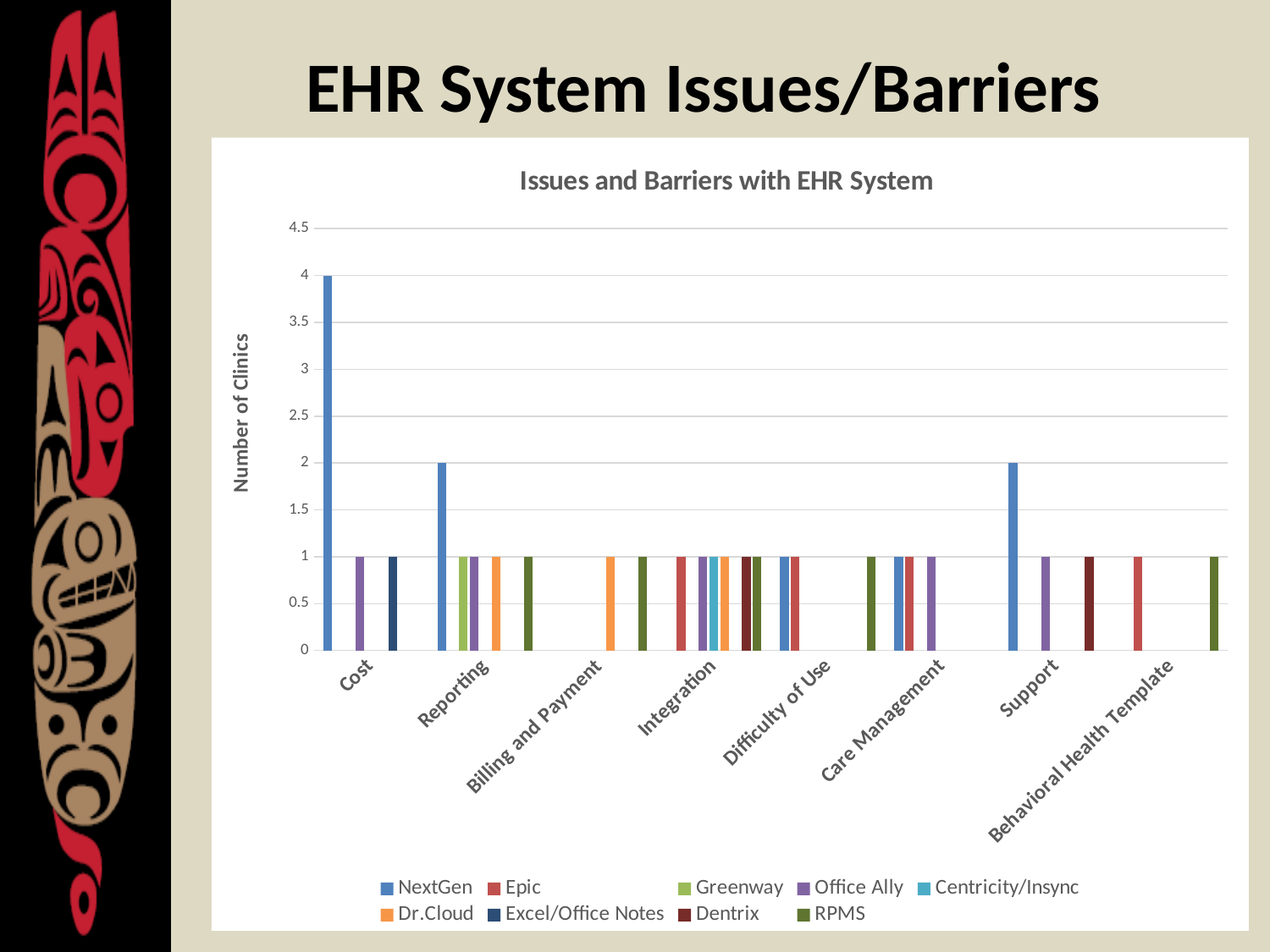
Which series has the tallest bar in the chart? NextGen What is the difference between the NextGen value for Cost and the NextGen value for Reporting? 2 What type of chart is shown on the slide? Bar chart What is the value for NextGen in the Reporting category? 2 What is the value for Office Ally in the Cost category? 1 Which category has the highest single bar? Cost Which is larger: the NextGen value for Cost or the NextGen value for Support? Cost What is the value for NextGen in the Support category? 2 What is the value for NextGen in the Cost category? 4 What is the title of the y axis? Number of Clinics How many categories are shown on the x axis? 8 How many series does the legend list? 9